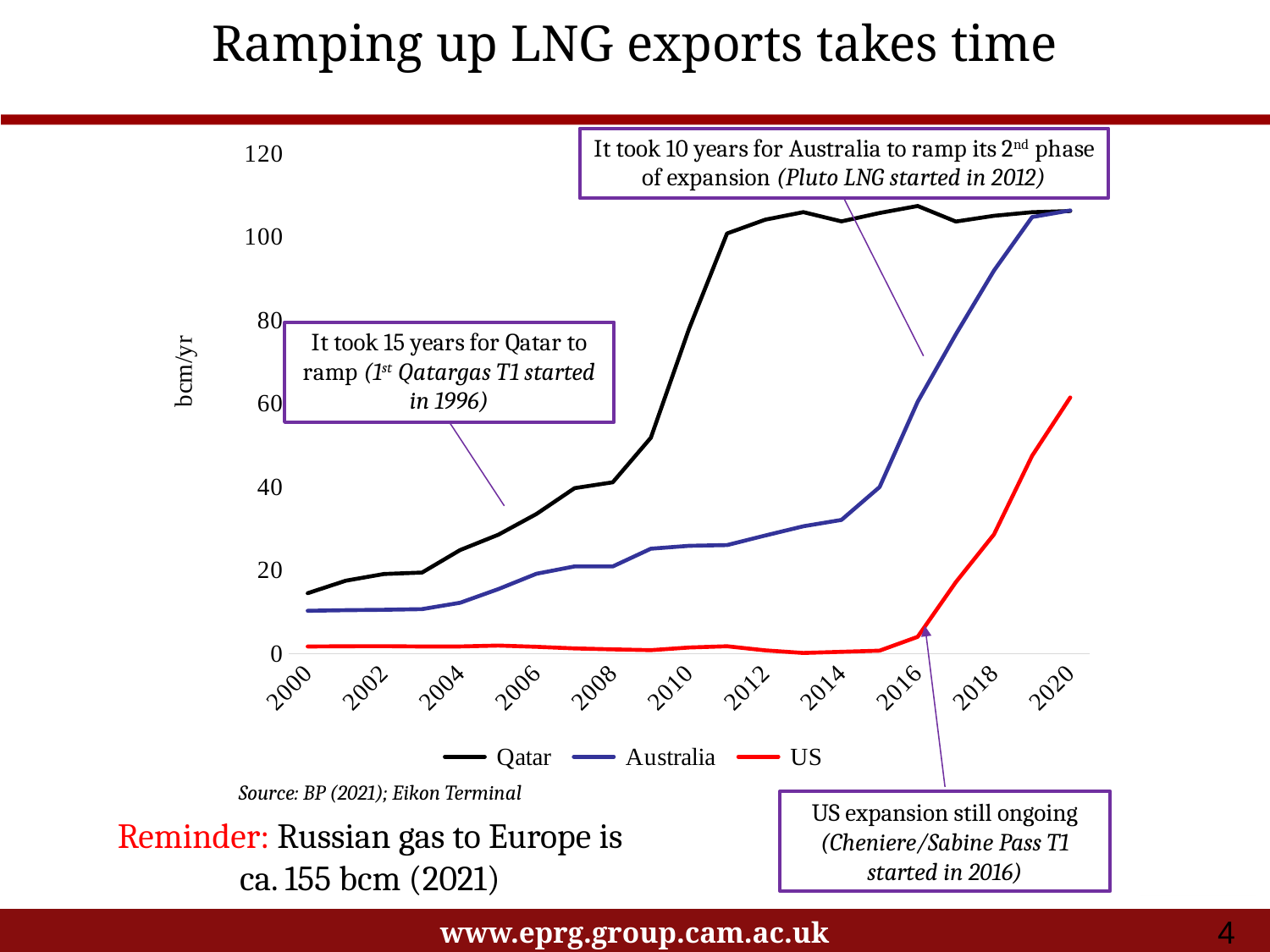
How many series does the legend list? 3 Is the value for Australia in 2020 greater or less than 100? greater What kind of chart is shown on the slide? line chart How many year labels are shown on the x axis? 11 In 2016, which is larger: the value for Qatar or the value for Australia? Qatar Is the value for US in 2018 greater or less than 40? less What is the label on the y axis? bcm/yr Does the US series rise or fall between 2016 and 2020? rise Which series is highest in 2010? Qatar Which series is lowest in 2020? US In 2020, which is larger: the value for Australia or the value for US? Australia Is the value for Qatar in 2000 greater or less than 20? less